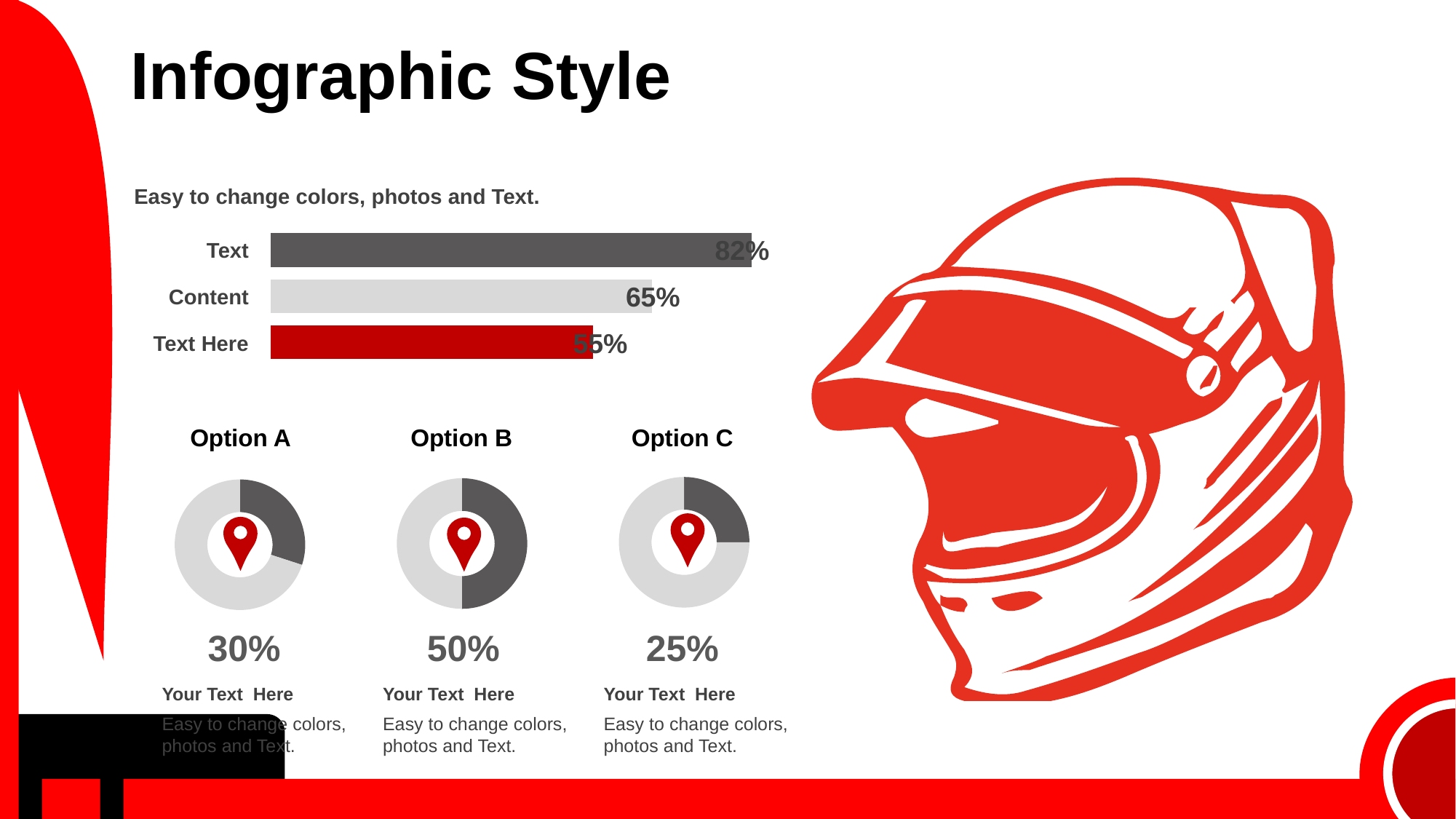
Which of the three donut charts (Option A, Option B, Option C) shows the smallest percentage? Option C In the horizontal bar chart, which bar is coloured red? Text Here What kind of chart is the chart with the categories Text, Content and Text Here? bar chart In the horizontal bar chart, which category has the highest value? Text In the horizontal bar chart, which category has the lowest value? Text Here In the horizontal bar chart, what is the value for Content? 65% In the horizontal bar chart, which is larger, the value for Content or the value for Text Here? Content In the horizontal bar chart, what is the value for Text? 82% How many categories does the horizontal bar chart show? 3 In the horizontal bar chart, what is the value for Text Here? 55% In the horizontal bar chart, what is the difference between the values for Text and Content? 17% In the donut chart for Option B, what percentage is shown? 50%